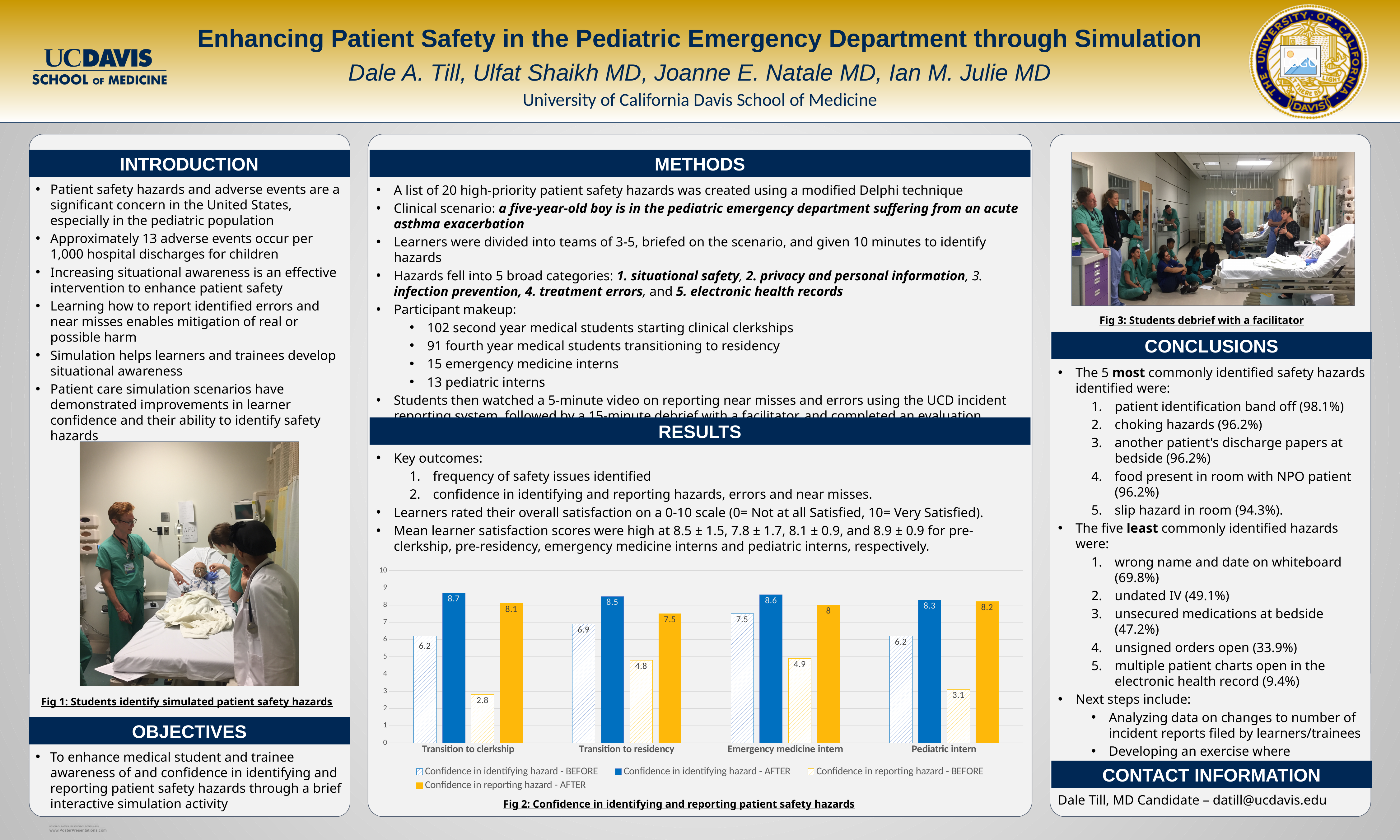
What is the caption of the chart? Fig 2: Confidence in identifying and reporting patient safety hazards Which category has the lowest value for 'Confidence in reporting hazard - BEFORE'? Transition to clerkship What is the value for 'Confidence in identifying hazard - BEFORE' for Pediatric intern? 6.2 What is the value for 'Confidence in reporting hazard - AFTER' for Emergency medicine intern? 8 What kind of chart is shown in Fig 2? Bar chart What is the value for 'Confidence in reporting hazard - BEFORE' for Transition to residency? 4.8 How many categories are shown on the x axis of the chart? 4 How many series does the chart legend list? 4 What is the difference between 'Confidence in reporting hazard - AFTER' and 'Confidence in reporting hazard - BEFORE' for Transition to clerkship? 5.3 Which is larger for Pediatric intern: 'Confidence in identifying hazard - AFTER' or 'Confidence in reporting hazard - AFTER'? Confidence in identifying hazard - AFTER What is the value for 'Confidence in identifying hazard - AFTER' for Transition to clerkship? 8.7 Which category has the highest value for 'Confidence in identifying hazard - BEFORE'? Emergency medicine intern